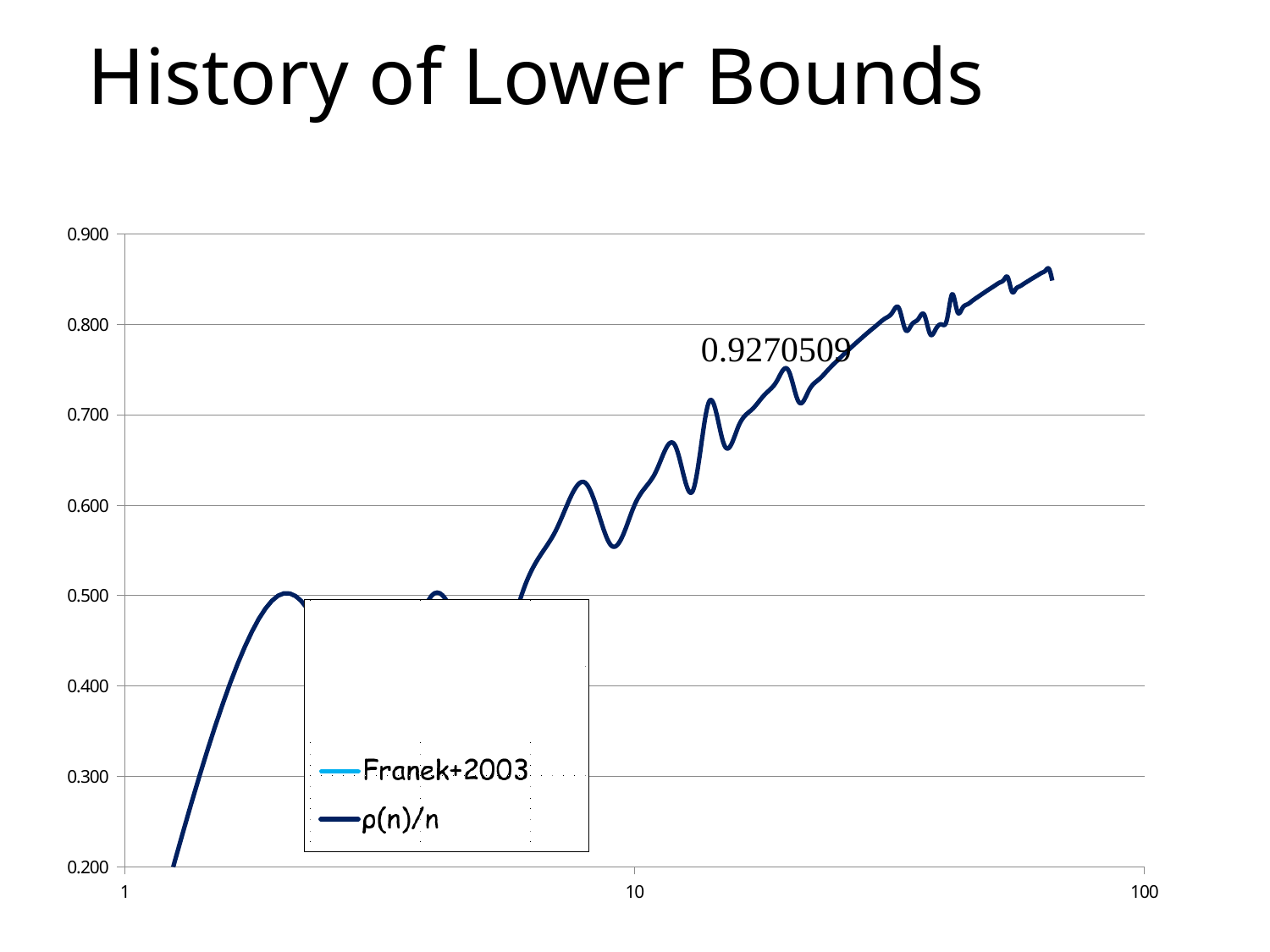
Is the value of ρ(n)/n at n = 20 greater or less than 0.600? greater What is the title of the slide containing the chart? History of Lower Bounds What kind of chart is shown on the slide? line chart Is the highest value reached by the ρ(n)/n line greater or less than 0.800? greater What are the two series named in the chart legend? Franek+2003 and ρ(n)/n How many series does the chart legend list? 2 Is the value of ρ(n)/n at n = 10 greater or less than 0.700? less Overall, does the ρ(n)/n line rise or fall as n increases along the x axis? rise What is the highest value labelled on the y axis of the chart? 0.900